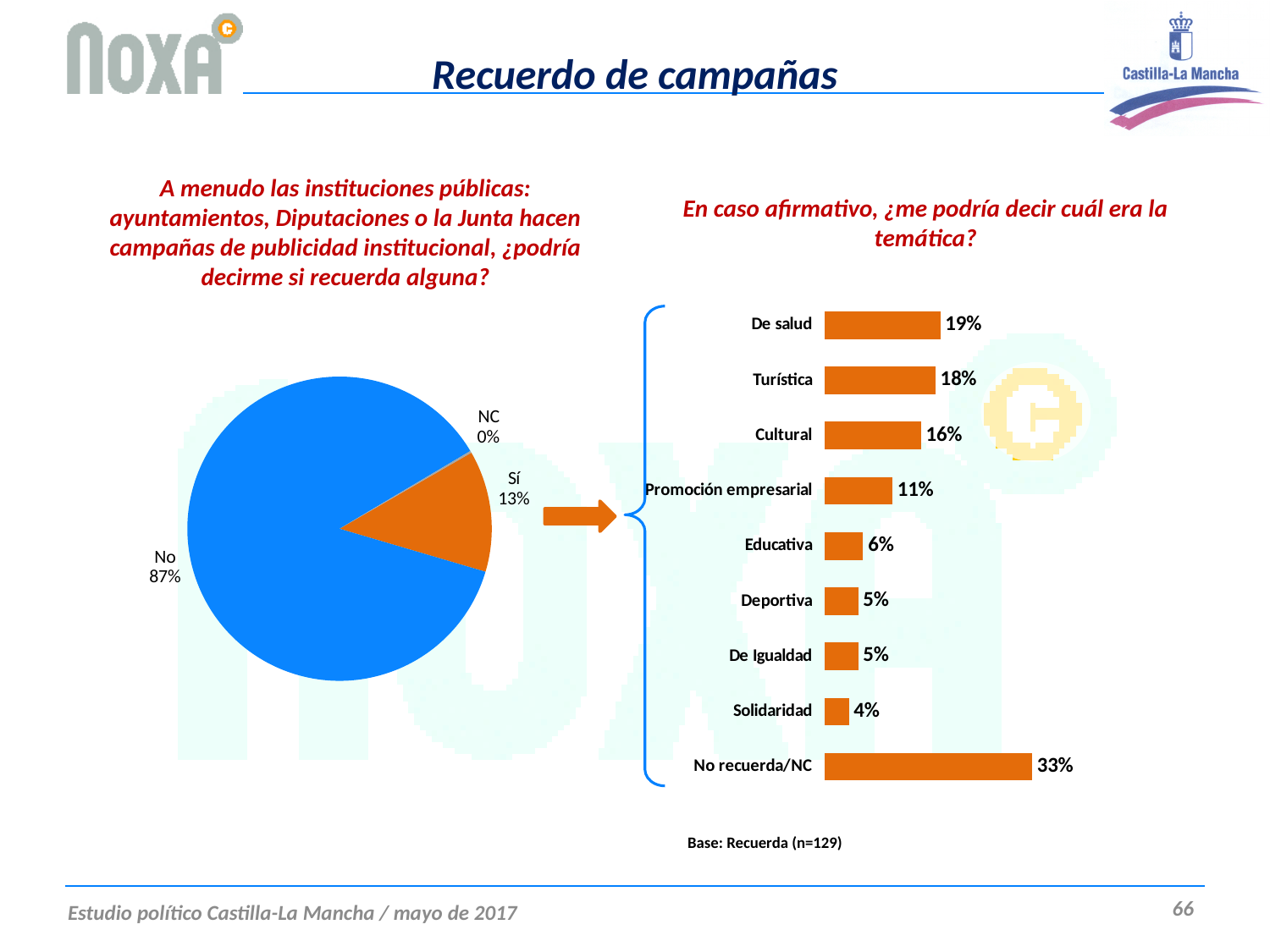
In the bar chart on the right, which category has the lowest value? Solidaridad In the pie chart on the left, which slice is the largest? No In the bar chart on the right, what is the difference between "De salud" and "Cultural"? 3% In the bar chart on the right, what is the value for "Promoción empresarial"? 11% In the pie chart on the left, what share of respondents answered "Sí"? 13% In the pie chart on the left, how many slices are labelled? 3 In the pie chart on the left, what share of respondents answered "No"? 87% In the bar chart on the right, which is larger, "Educativa" or "Deportiva"? Educativa In the bar chart on the right, how many categories are shown? 9 In the bar chart on the right, which category has the highest value? No recuerda/NC In the bar chart on the right, what is the value for "Turística"? 18% What type of chart is shown on the right side of the slide? Bar chart